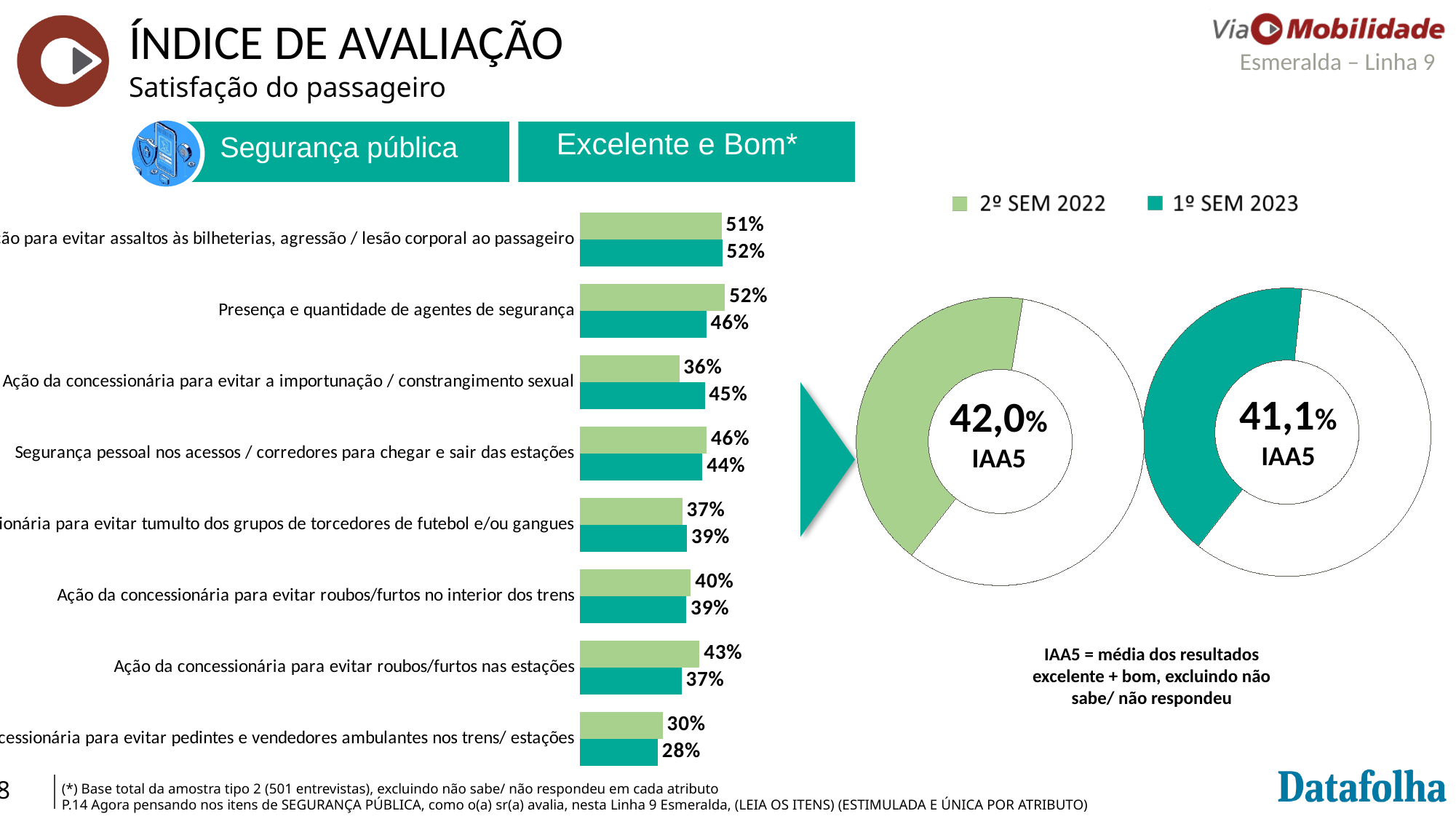
In the donut chart on the left (2º SEM 2022), what IAA5 value is shown? 42,0% In the bar chart, what is the 2º SEM 2022 value for "Ação da concessionária para evitar a importunação / constrangimento sexual"? 36% How many series does the legend of the bar chart list? 2 In the bar chart, which category has the highest 2º SEM 2022 value? Presença e quantidade de agentes de segurança In the bar chart, what is the 2º SEM 2022 value for "Ação da concessionária para evitar roubos/furtos nas estações"? 43% In the bar chart, what is the 1º SEM 2023 value for "Presença e quantidade de agentes de segurança"? 46% In the bar chart, for "Ação da concessionária para evitar roubos/furtos no interior dos trens", which is larger: the 2º SEM 2022 value or the 1º SEM 2023 value? 2º SEM 2022 In the donut chart on the right (1º SEM 2023), what IAA5 value is shown? 41,1% How many categories does the bar chart show? 8 In the bar chart, what is the 1º SEM 2023 value for "Segurança pessoal nos acessos / corredores para chegar e sair das estações"? 44% In the bar chart, what is the difference between the 1º SEM 2023 and 2º SEM 2022 values for "Ação da concessionária para evitar a importunação / constrangimento sexual"? 9 percentage points What type of chart is used on the left side of the slide to show the attribute ratings? Bar chart